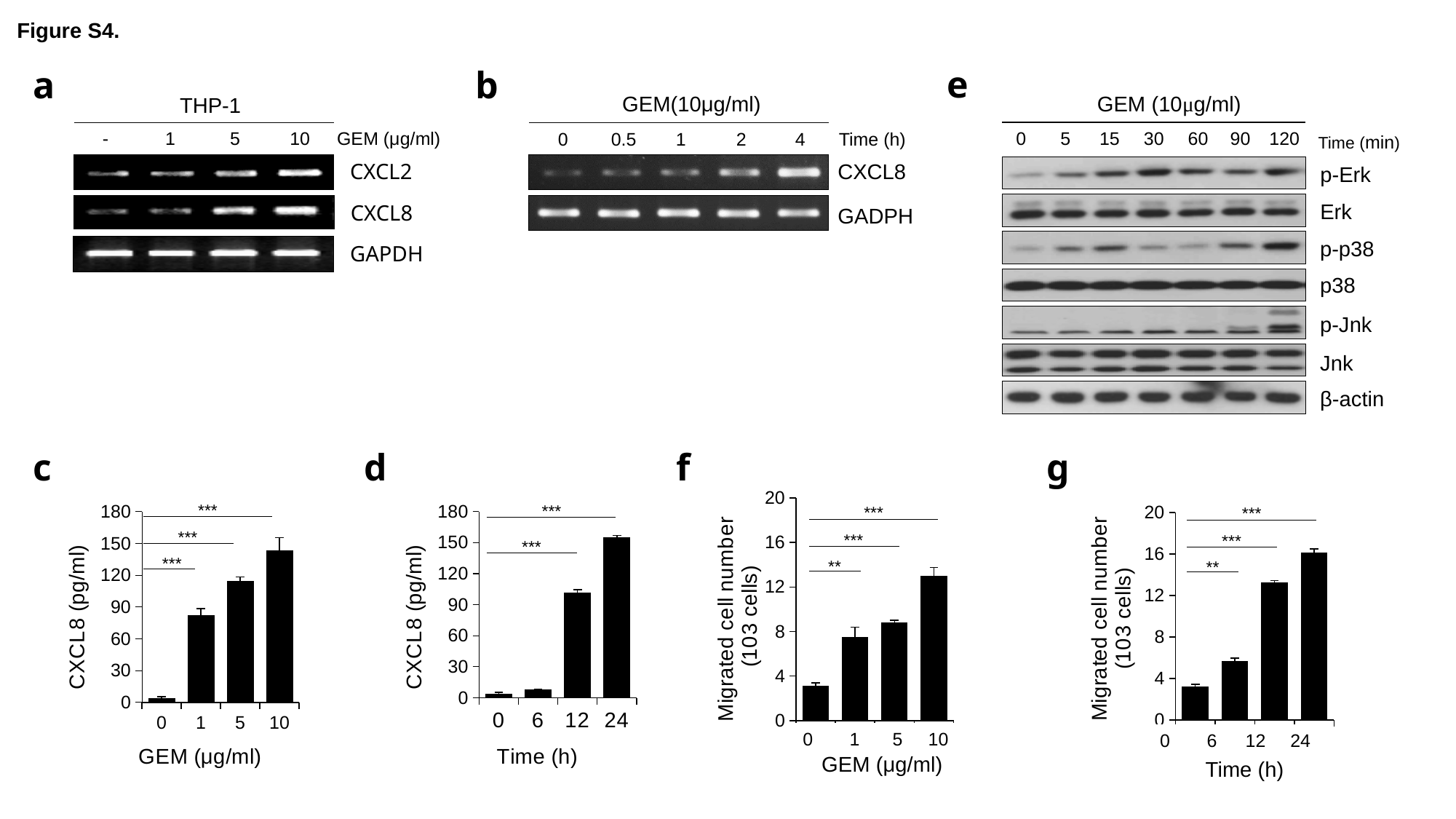
In chart c (CXCL8 vs GEM), which GEM concentration gives the highest CXCL8 level? 10 In chart d (CXCL8 vs Time), is the CXCL8 value at 6 h greater or less than 30? less In chart c (CXCL8 vs GEM), is the CXCL8 value at 1 µg/ml GEM greater or less than 60? greater In chart f (Migrated cell number vs GEM), is the value at 10 µg/ml GEM greater or less than 12? greater In chart d (CXCL8 vs Time), which time point has the lowest CXCL8 level? 0 In chart f (Migrated cell number vs GEM), which is larger, the value at 1 µg/ml or at 10 µg/ml? 10 µg/ml What kind of chart is chart g (Migrated cell number vs Time)? bar chart In chart c (CXCL8 vs GEM), how many GEM concentrations are plotted? 4 In chart d (CXCL8 vs Time), do the CXCL8 values rise or fall as time increases? rise